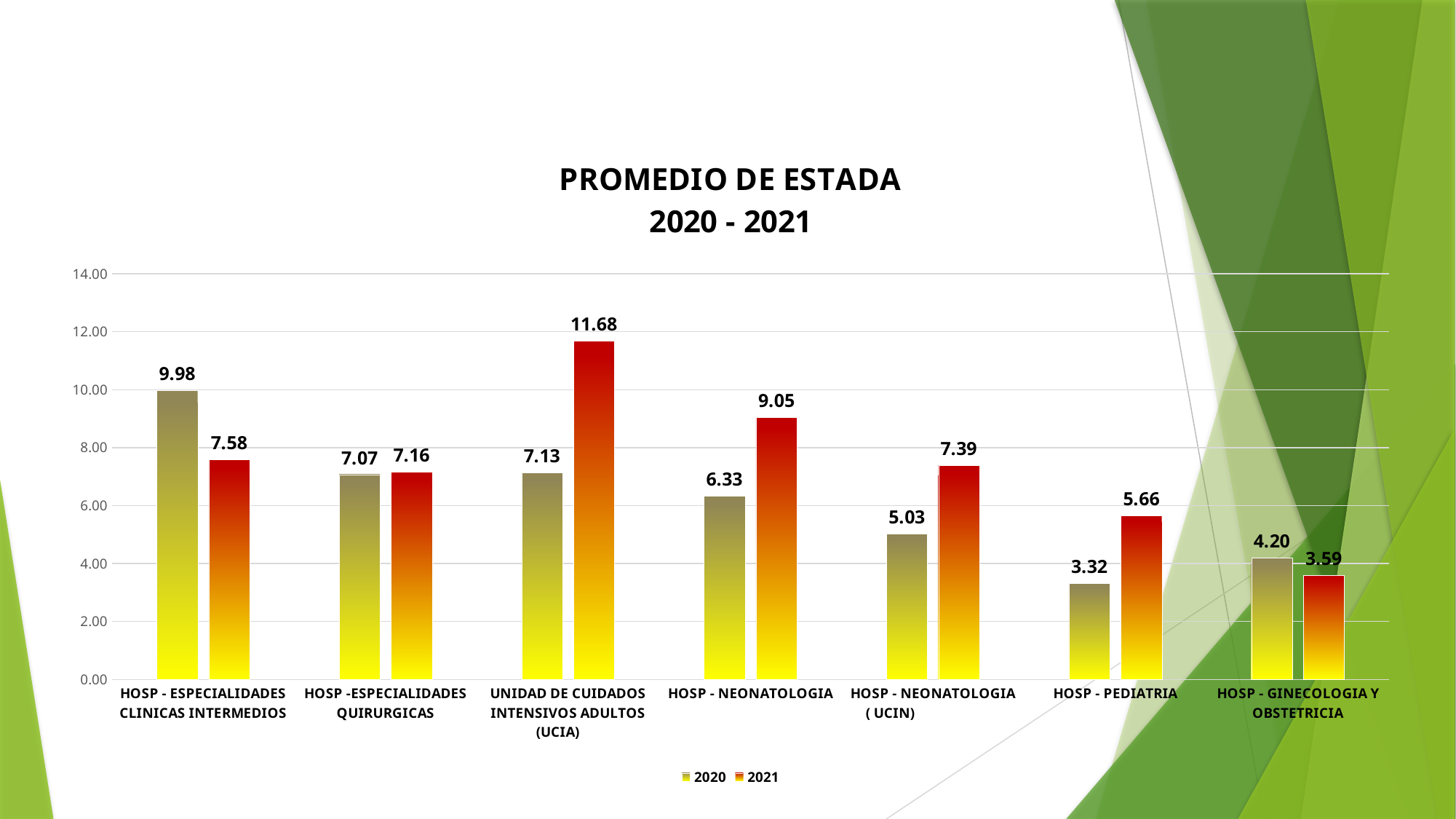
How many series does the legend list? 2 Which category has the lowest 2020 value? HOSP - PEDIATRIA What is the title of the chart? PROMEDIO DE ESTADA 2020 - 2021 Which is larger for HOSP - GINECOLOGIA Y OBSTETRICIA, the 2020 value or the 2021 value? 2020 What is the 2021 value for UNIDAD DE CUIDADOS INTENSIVOS ADULTOS (UCIA)? 11.68 What is the 2020 value for HOSP - ESPECIALIDADES CLINICAS INTERMEDIOS? 9.98 What is the difference between the 2021 and 2020 values for HOSP - NEONATOLOGIA? 2.72 What kind of chart is shown? Bar chart Which category has the highest 2021 value? UNIDAD DE CUIDADOS INTENSIVOS ADULTOS (UCIA) What is the 2021 value for HOSP - PEDIATRIA? 5.66 How many categories are shown on the x axis? 7 What is the difference between the 2020 values for HOSP - ESPECIALIDADES CLINICAS INTERMEDIOS and HOSP - PEDIATRIA? 6.66